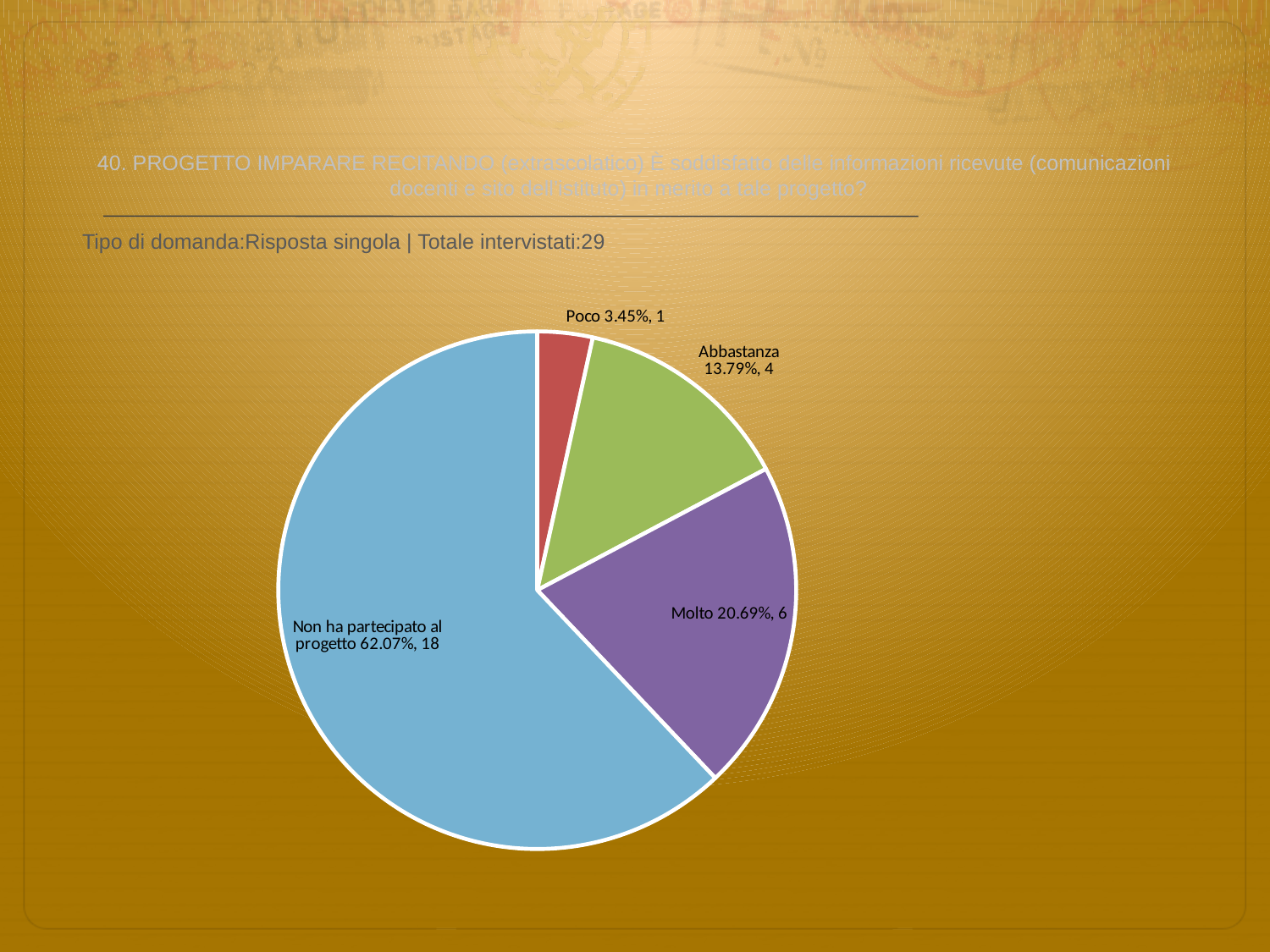
What colour is the 'Molto' slice? purple How many slices does the pie chart have? 4 Which slice is the largest? Non ha partecipato al progetto What kind of chart is shown on the slide? pie chart Which has more respondents, 'Molto' or 'Abbastanza'? Molto Which slice is the smallest? Poco How many respondents chose 'Abbastanza'? 4 What is the difference in count between 'Molto' and 'Abbastanza'? 2 How many respondents chose 'Poco'? 1 What percentage is shown for the 'Molto' slice? 20.69% What percentage is shown for 'Non ha partecipato al progetto'? 62.07% What share of the pie does the 'Abbastanza' slice represent? 13.79%